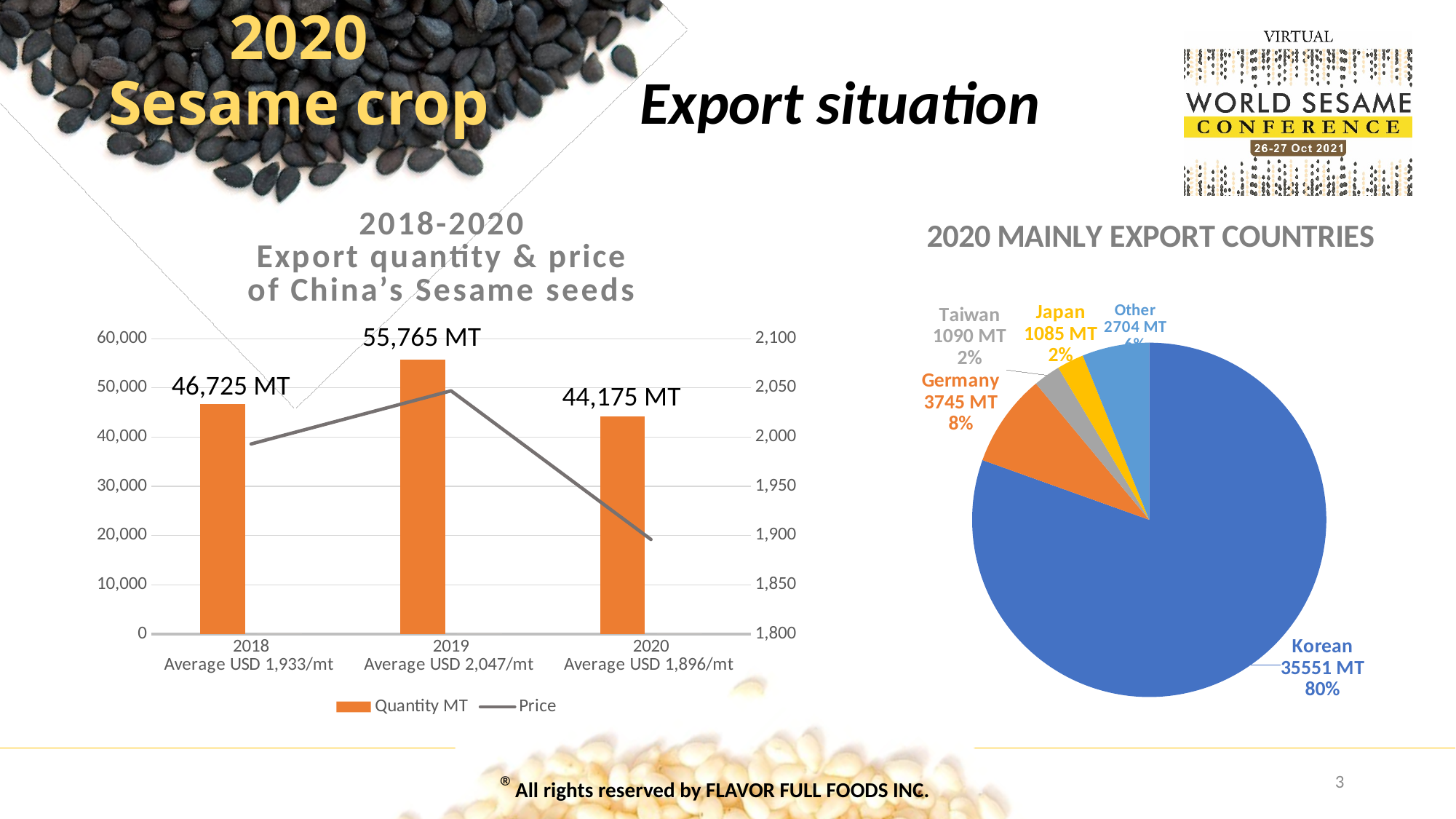
In the '2018-2020 Export quantity & price of China's Sesame seeds' chart, what was the export quantity in 2019? 55,765 MT What kind of chart is the '2020 MAINLY EXPORT COUNTRIES' chart? pie chart In the '2018-2020 Export quantity & price of China's Sesame seeds' chart, did the price rise or fall from 2019 to 2020? fall In the '2018-2020 Export quantity & price of China's Sesame seeds' chart, which year had the lowest export quantity? 2020 In the '2018-2020 Export quantity & price of China's Sesame seeds' chart, what is the difference in export quantity between 2019 and 2018? 9,040 MT In the '2018-2020 Export quantity & price of China's Sesame seeds' chart, which year had the highest export quantity? 2019 In the '2020 MAINLY EXPORT COUNTRIES' pie chart, what quantity was exported to Germany? 3745 MT In the '2018-2020 Export quantity & price of China's Sesame seeds' chart, what was the export quantity in 2020? 44,175 MT In the '2020 MAINLY EXPORT COUNTRIES' pie chart, what share of exports went to Korean? 80% In the '2020 MAINLY EXPORT COUNTRIES' pie chart, how many slices are there? 5 In the '2018-2020 Export quantity & price of China's Sesame seeds' chart, how many series does the legend list? 2 In the '2018-2020 Export quantity & price of China's Sesame seeds' chart, what was the average price per mt in 2019? USD 2,047/mt